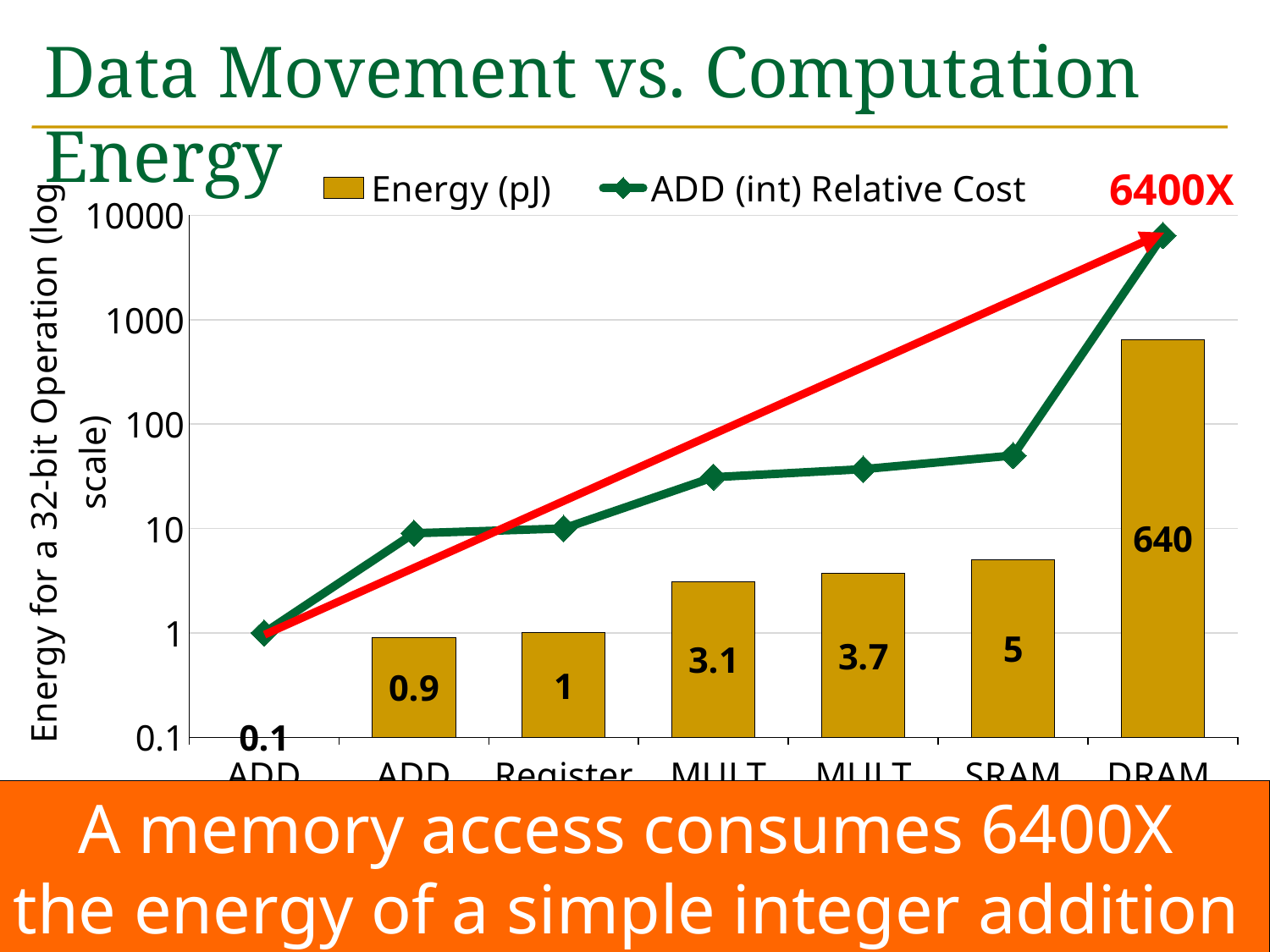
What is the Energy (pJ) value shown for Register? 1 What is the Energy (pJ) value shown for DRAM? 640 How many series does the legend list? 2 What kind of chart is this? Combined bar and line chart How many categories are shown on the x axis? 7 Which category has the highest Energy (pJ) bar? DRAM Is the ADD (int) Relative Cost value at SRAM greater or less than 10? greater Which has a larger Energy (pJ) value, SRAM or Register? SRAM Is the ADD (int) Relative Cost value at DRAM greater or less than 1000? greater What is the difference between the Energy (pJ) values for DRAM and SRAM? 635 What is the Energy (pJ) value shown for SRAM? 5 Which category has the lowest Energy (pJ) value? ADD (the first category, 0.1)